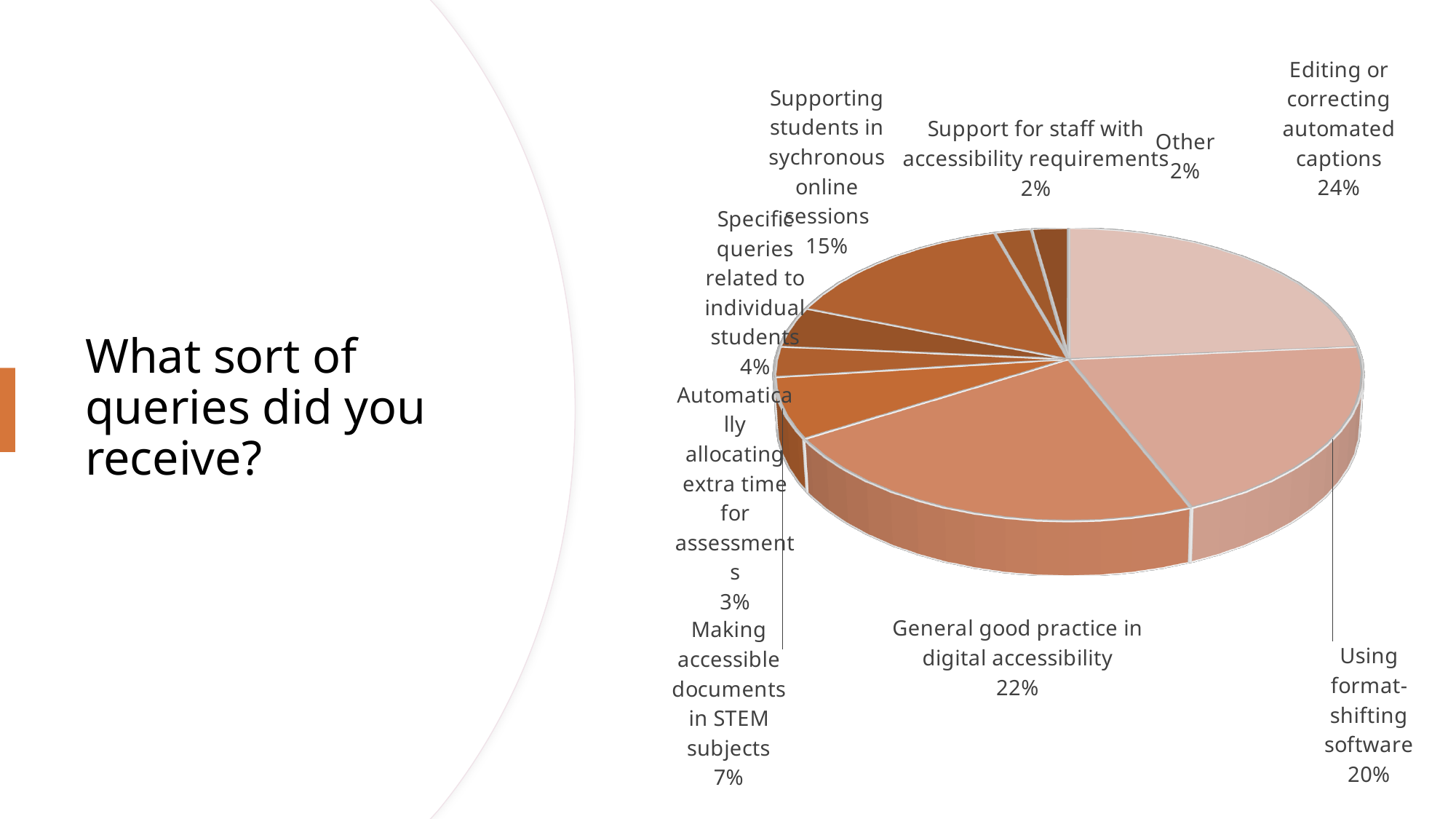
Which has a larger share: general good practice in digital accessibility or supporting students in synchronous online sessions? General good practice in digital accessibility Which category of query has the largest share of the pie? Editing or correcting automated captions What share of queries was about general good practice in digital accessibility? 22% What is the title of the slide containing the pie chart? What sort of queries did you receive? What percentage of queries was about automatically allocating extra time for assessments? 3% What kind of chart is shown on the slide? Pie chart What percentage of queries was about supporting students in synchronous online sessions? 15% What share of queries was about editing or correcting automated captions? 24% What is the difference in percentage points between editing or correcting automated captions and using format-shifting software? 4 percentage points What share of queries was about making accessible documents in STEM subjects? 7% How many categories of query are shown in the pie chart? 9 What percentage of queries concerned using format-shifting software? 20%